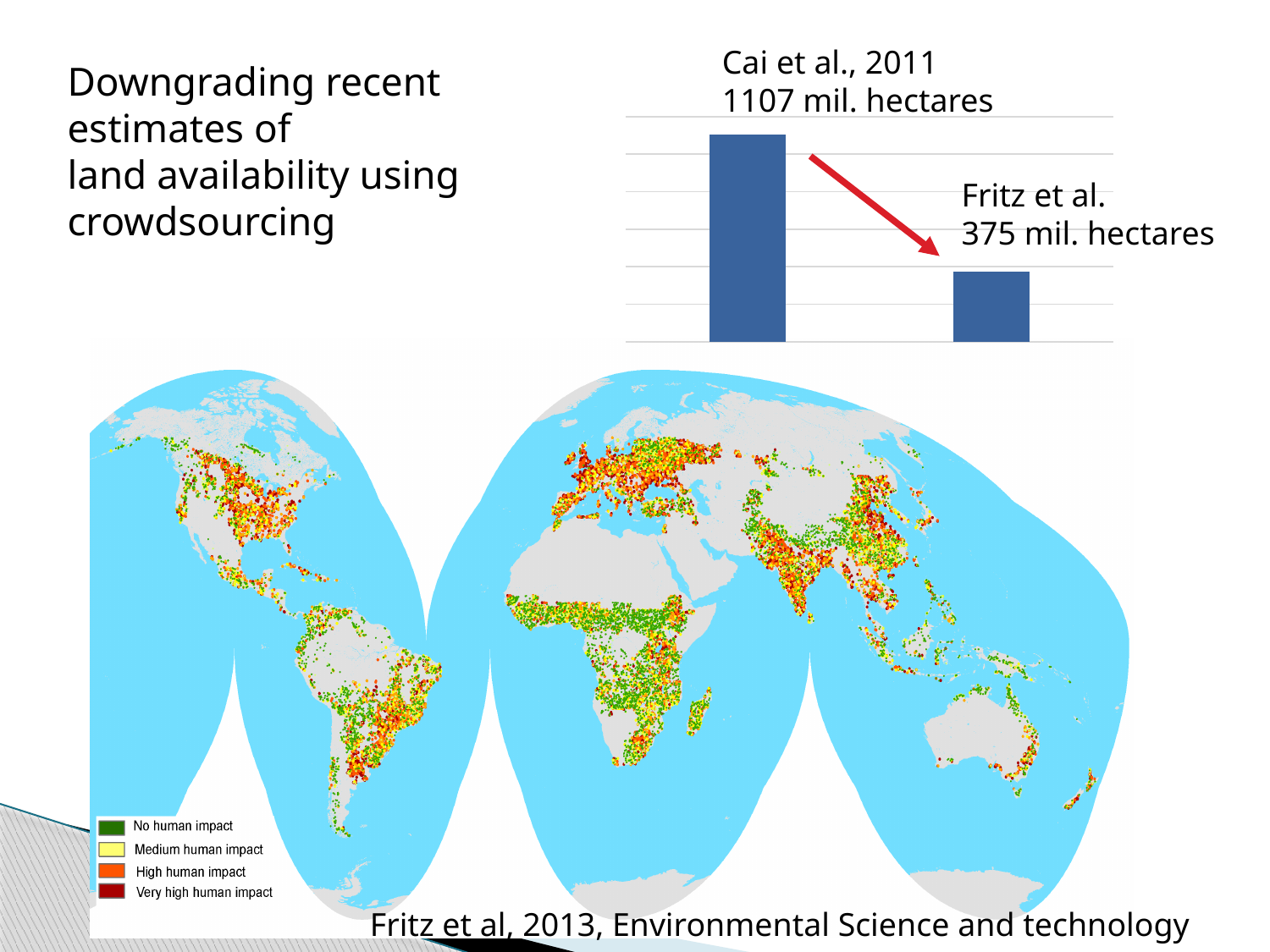
In the bar chart, what is the land availability estimate for Cai et al., 2011? 1107 mil. hectares What colour is the arrow drawn between the two bars in the bar chart? Red In the bar chart, which estimate is the highest? Cai et al., 2011 In the bar chart, which estimate is the lowest? Fritz et al. What colour are the bars in the bar chart? Blue In the bar chart, which is larger: the Cai et al., 2011 estimate or the Fritz et al. estimate? Cai et al., 2011 In the bar chart, do the values rise or fall from the left bar to the right bar? Fall In the bar chart, what is the land availability estimate for Fritz et al.? 375 mil. hectares What kind of chart is shown at the top right of the slide? Bar chart In the bar chart, what is the difference between the Cai et al., 2011 estimate and the Fritz et al. estimate? 732 mil. hectares How many bars are shown in the bar chart? 2